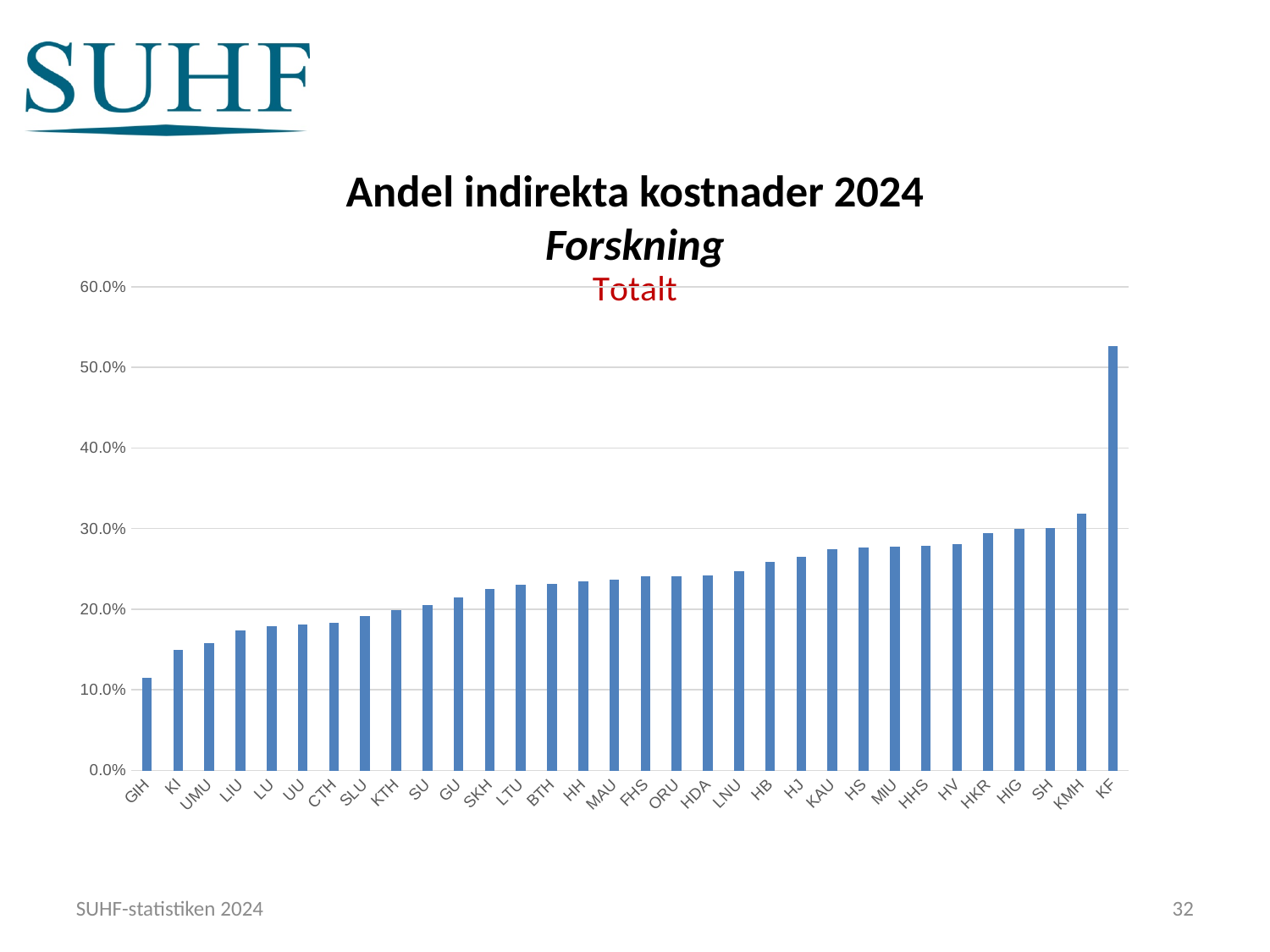
Is the value for HB greater or less than 20.0%? greater Do the values generally rise or fall from left to right along the x axis? Rise Is the value for KI greater or less than 20.0%? less How many categories are shown on the x axis? 32 Which is larger, the value for KMH or the value for LU? KMH What kind of chart is shown on the slide? Bar chart Is the value for KF greater or less than 50.0%? greater What is the first line of the chart title? Andel indirekta kostnader 2024 Which category has the lowest value in the chart? GIH Which category has the highest value in the chart? KF